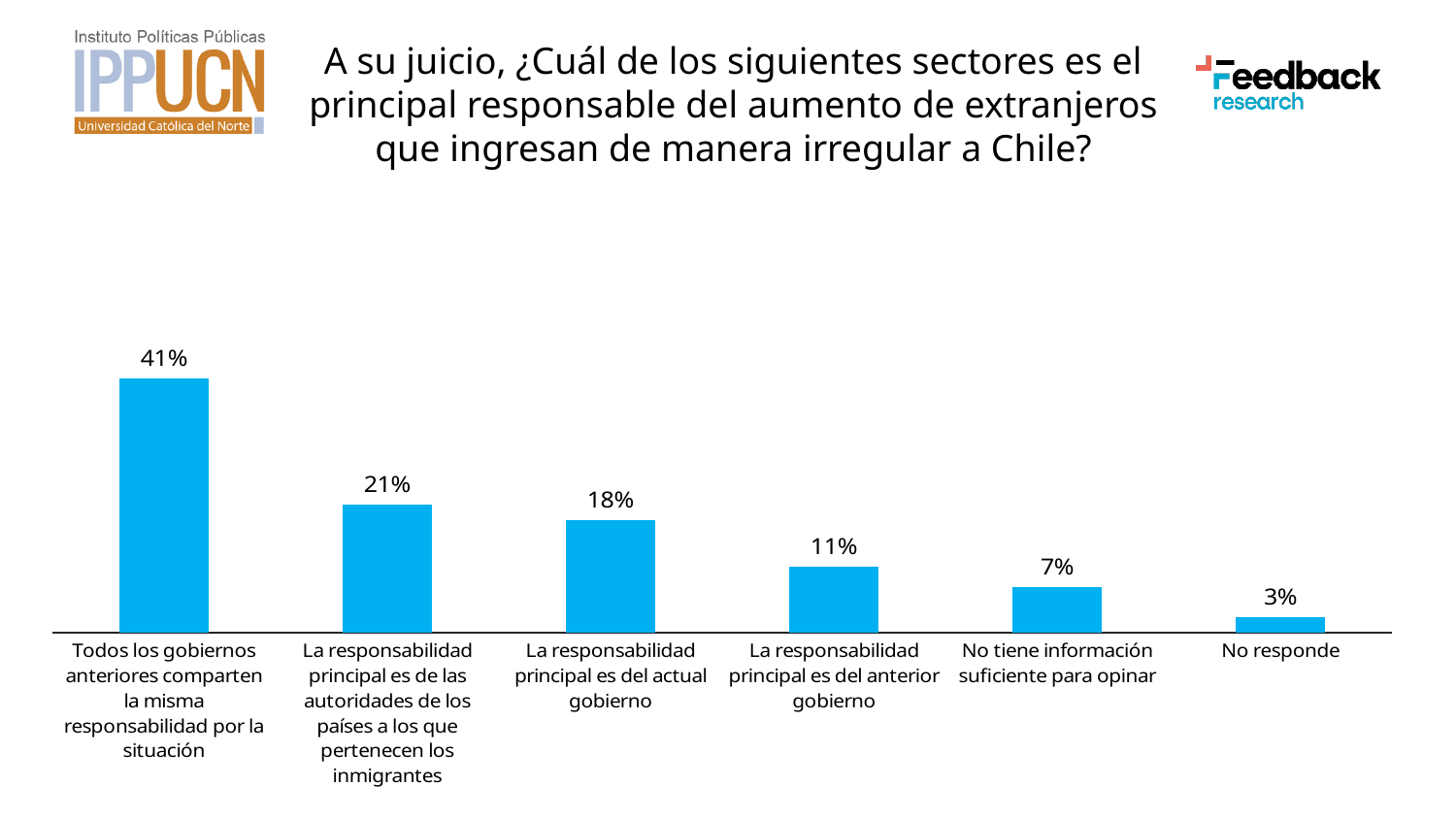
What is the value for "No responde"? 3% What is the difference between the highest and lowest values in the chart? 38% Do the values rise or fall from left to right along the x axis? Fall What kind of chart is shown on the slide? Bar chart What is the difference between the value for "La responsabilidad principal es de las autoridades de los países a los que pertenecen los inmigrantes" and the value for "La responsabilidad principal es del anterior gobierno"? 10% Which category has the lowest value? No responde Which is larger: the value for "La responsabilidad principal es del actual gobierno" or the value for "La responsabilidad principal es del anterior gobierno"? La responsabilidad principal es del actual gobierno What is the value for "La responsabilidad principal es del actual gobierno"? 18% Which category has the highest value? Todos los gobiernos anteriores comparten la misma responsabilidad por la situación What is the value for "No tiene información suficiente para opinar"? 7% What is the value for "Todos los gobiernos anteriores comparten la misma responsabilidad por la situación"? 41% How many categories are shown in the chart? 6